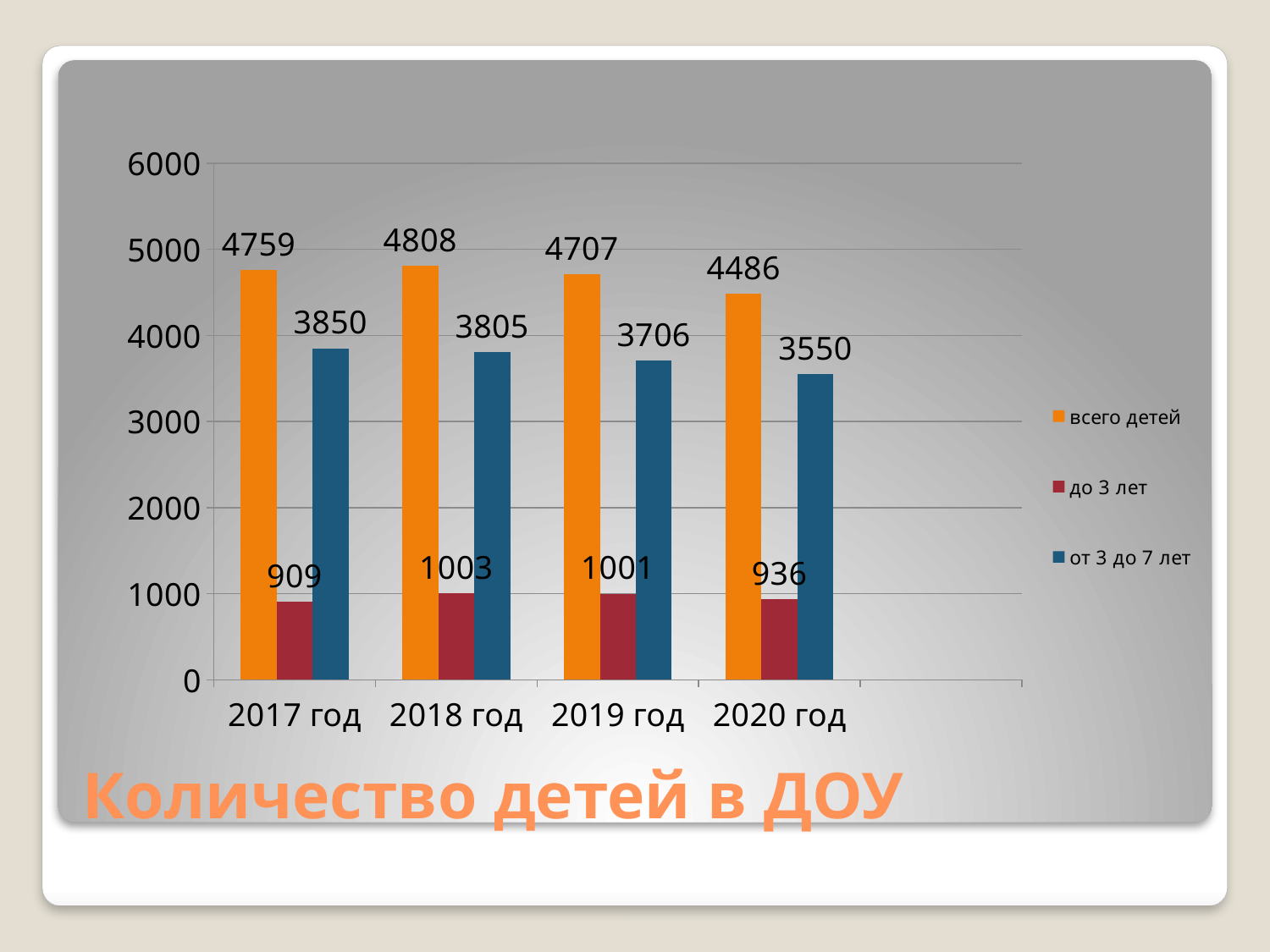
What is the value for "от 3 до 7 лет" in 2020 год? 3550 Which is larger: the "до 3 лет" value for 2018 год or for 2020 год? 2018 год Does the value for "от 3 до 7 лет" rise or fall from 2017 год to 2020 год? fall What is the value for "до 3 лет" in 2017 год? 909 How many series does the legend list? 3 How many years are shown on the x axis? 4 What is the value for "всего детей" in 2018 год? 4808 In which year is the value for "от 3 до 7 лет" the lowest? 2020 год What is the title of the chart? Количество детей в ДОУ What kind of chart is shown on the slide? bar chart What is the difference between the "всего детей" values for 2017 год and 2020 год? 273 In which year is the value for "всего детей" the highest? 2018 год